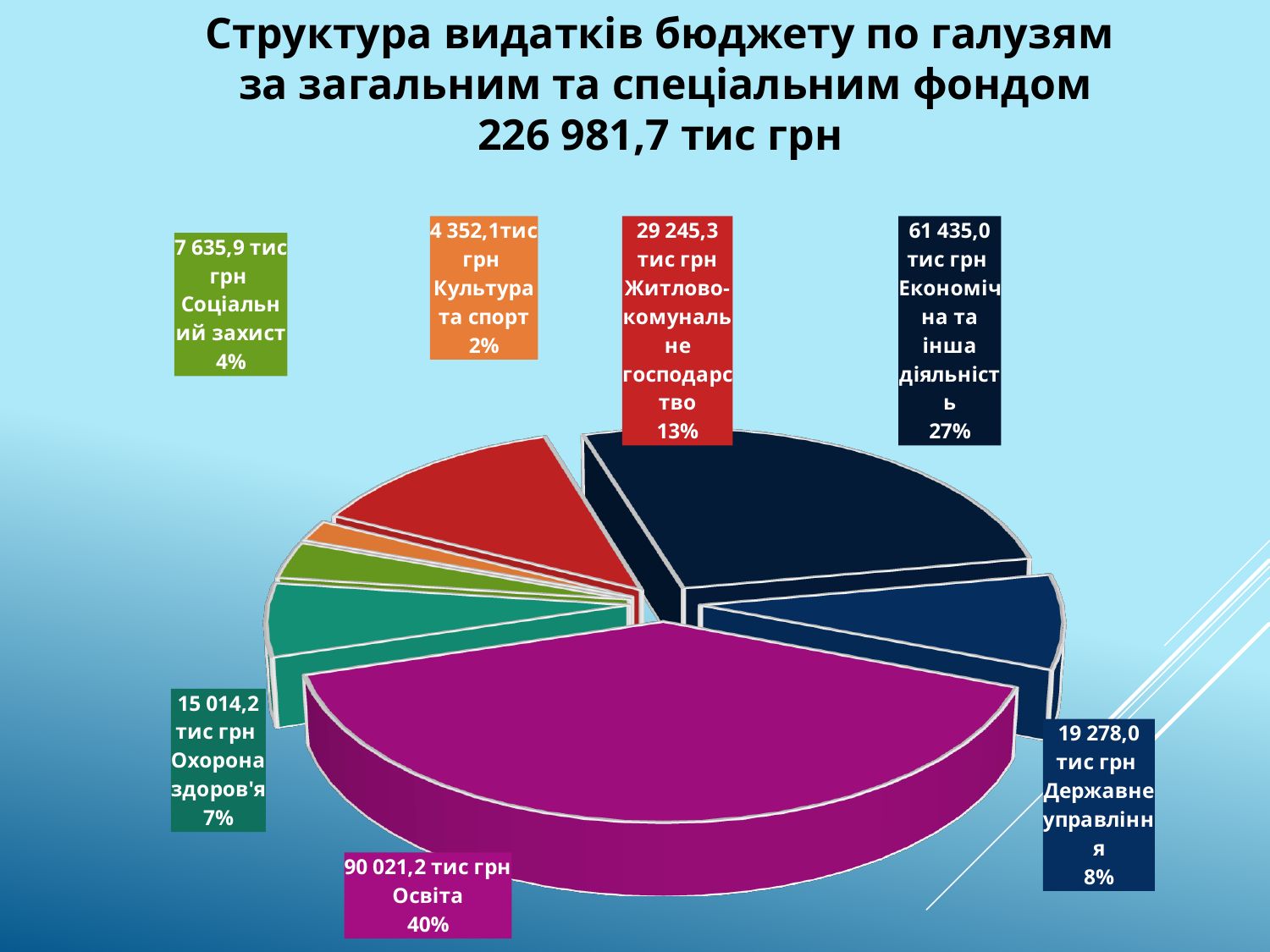
What is the value for Охорона здоров'я? 15 014,2 тис грн What share of the pie does Економічна та інша діяльність represent? 27% What is the value for Освіта? 90 021,2 тис грн Which category has the smallest share of the pie? Культура та спорт What share of the pie does Житлово-комунальне господарство represent? 13% What kind of chart is shown on the slide? pie chart Which category has the largest share of the pie? Освіта How many categories are shown in the pie chart? 7 Which is larger, Державне управління or Соціальний захист? Державне управління What total amount is stated in the chart title? 226 981,7 тис грн What is the difference in percentage points between Освіта and Економічна та інша діяльність? 13 What is the value for Державне управління? 19 278,0 тис грн